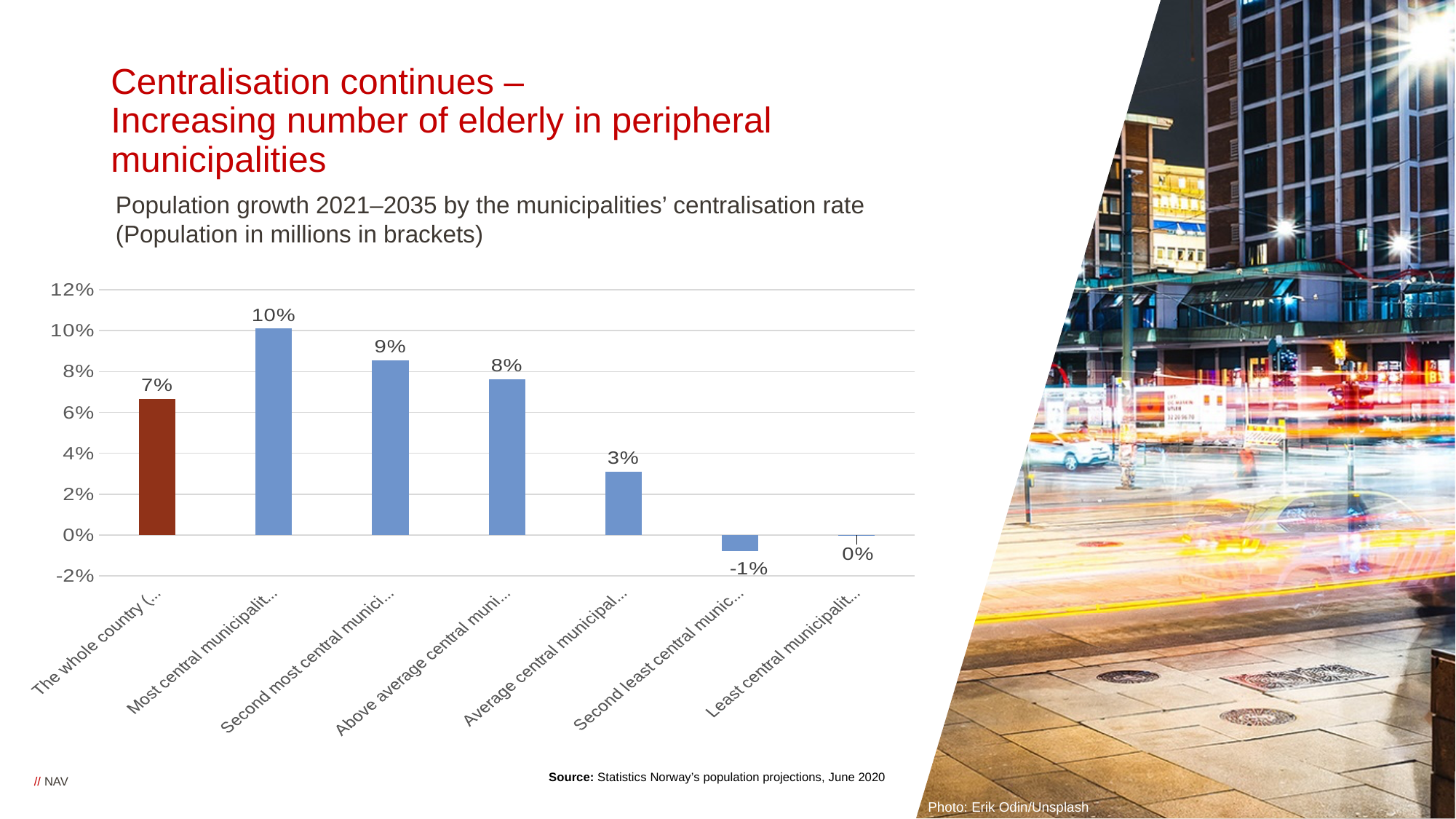
What is the population growth value shown for 'The whole country'? 7% What value is shown for the 'Least central municipalities' bar? 0% What kind of chart is shown on the slide? Bar chart What is the population growth value shown for the 'Most central municipalities' bar? 10% Which category has the lowest population growth in the chart? Second least central municipalities Which category has the highest population growth in the chart? Most central municipalities How many categories are plotted in the chart? 7 What value is shown for the 'Average central municipalities' bar? 3% What is the difference between the value for 'Most central municipalities' and the value for 'The whole country'? 3 percentage points Which is larger: the value for 'Second most central municipalities' or the value for 'Above average central municipalities'? Second most central municipalities Moving from 'Most central municipalities' to 'Least central municipalities', do the values rise or fall? Fall Is the value for 'Above average central municipalities' greater or less than 6%? greater